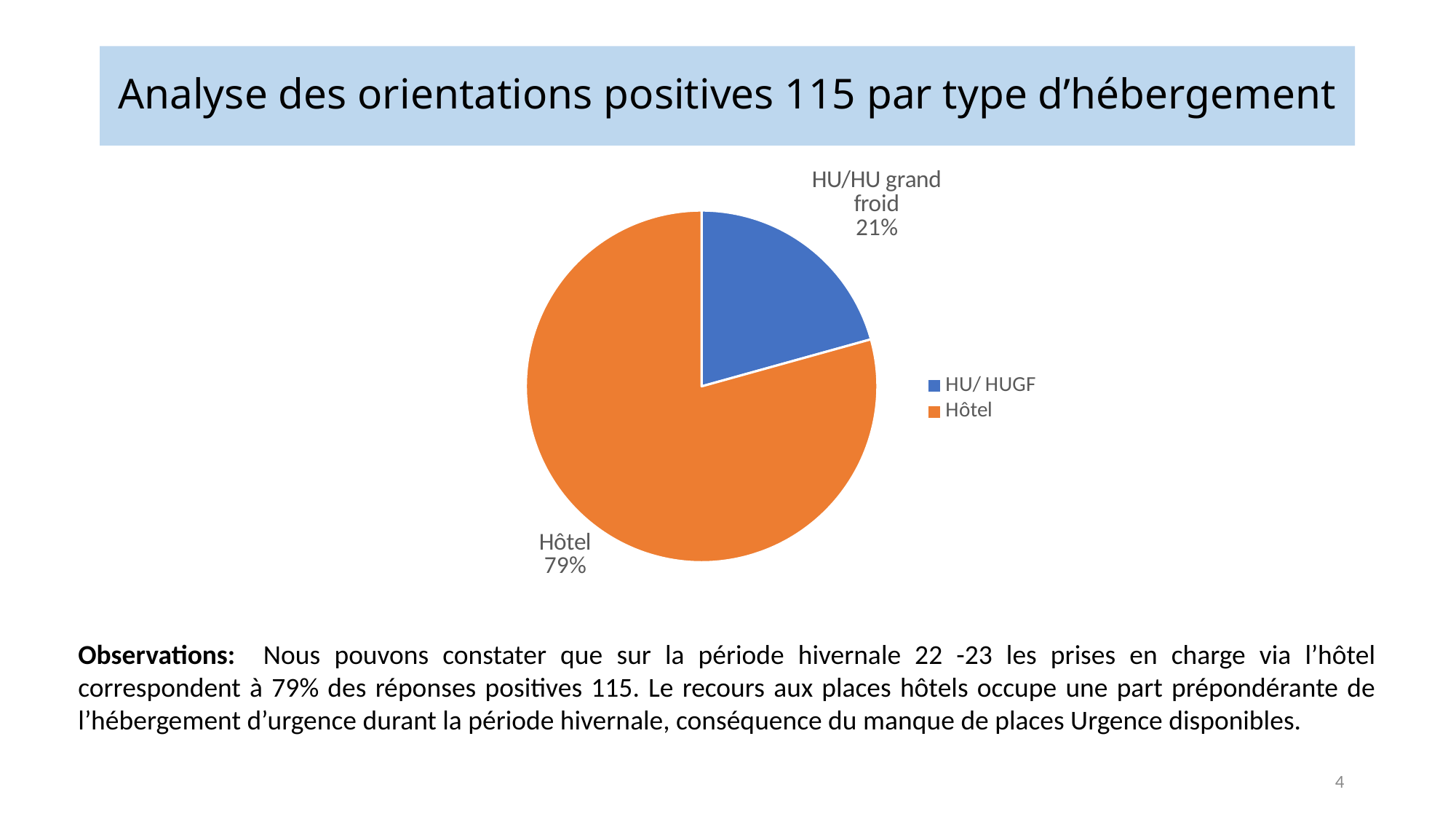
What share of the pie does Hôtel represent? 79% Which is larger, the Hôtel slice or the HU/HU grand froid slice? Hôtel Which category has the largest slice of the pie? Hôtel Which category has the smallest slice of the pie? HU/HU grand froid How many entries does the legend list? 2 How many slices does the pie chart have? 2 What kind of chart is shown on the slide? pie chart What share of the pie does HU/HU grand froid represent? 21% What is the difference in percentage points between the Hôtel slice and the HU/HU grand froid slice? 58 What colour is the HU/ HUGF slice? blue What colour is the Hôtel slice? orange